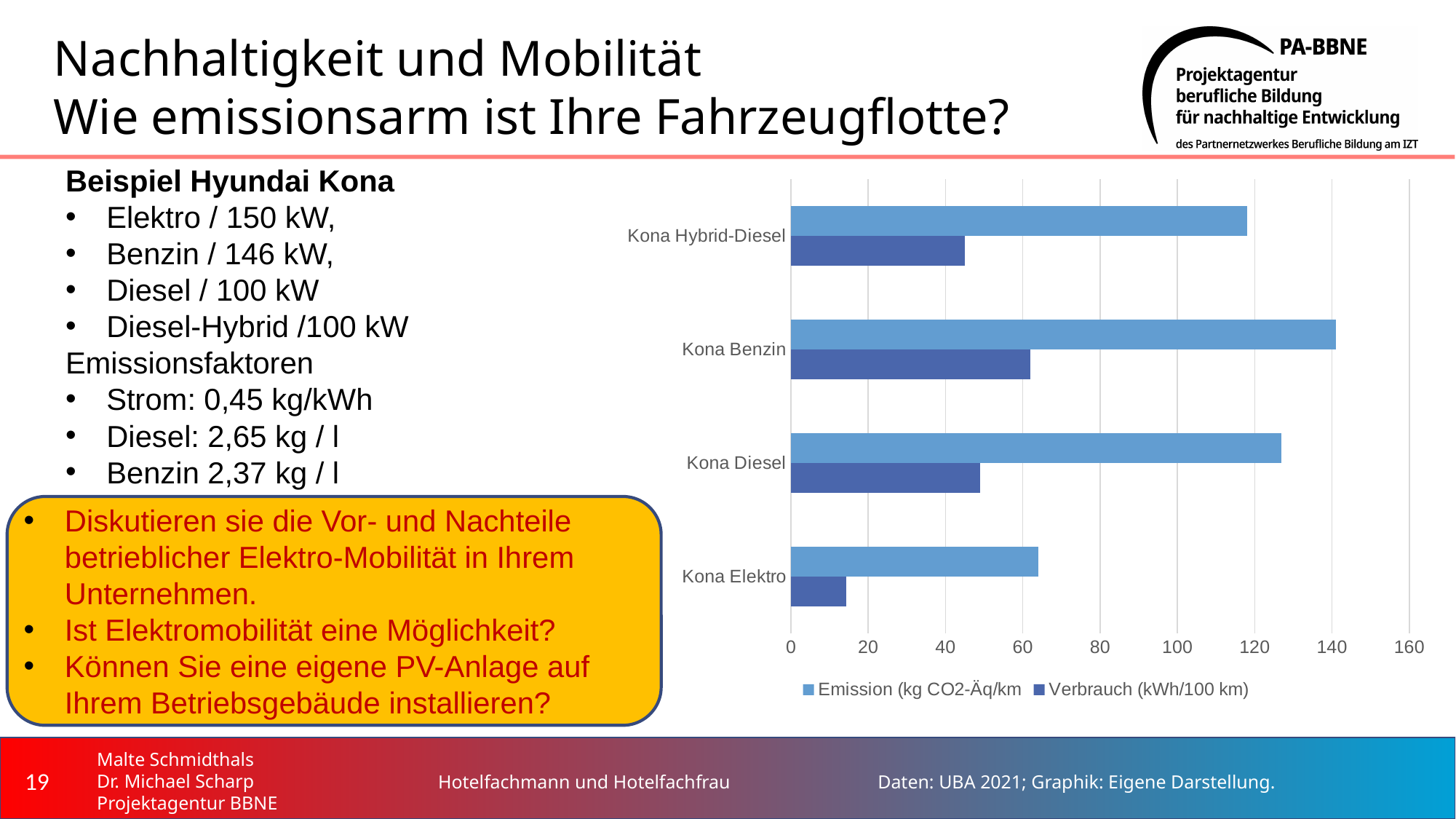
Is the Verbrauch value for Kona Elektro greater or less than 20? less Is the Emission value for Kona Elektro greater or less than 80? less How many series does the chart legend list? 2 Which vehicle has the highest Emission (kg CO2-Äq/km) value? Kona Benzin Which vehicle has the lowest Emission (kg CO2-Äq/km) value? Kona Elektro What kind of chart is shown on the slide? bar chart Which is larger, the Emission value for Kona Diesel or the Emission value for Kona Hybrid-Diesel? Kona Diesel Is the Emission value for Kona Benzin greater or less than 120? greater What is the label of the second series in the chart legend? Verbrauch (kWh/100 km) How many vehicle categories are shown on the chart? 4 Which vehicle has the lowest Verbrauch (kWh/100 km) value? Kona Elektro Which vehicle has the highest Verbrauch (kWh/100 km) value? Kona Benzin